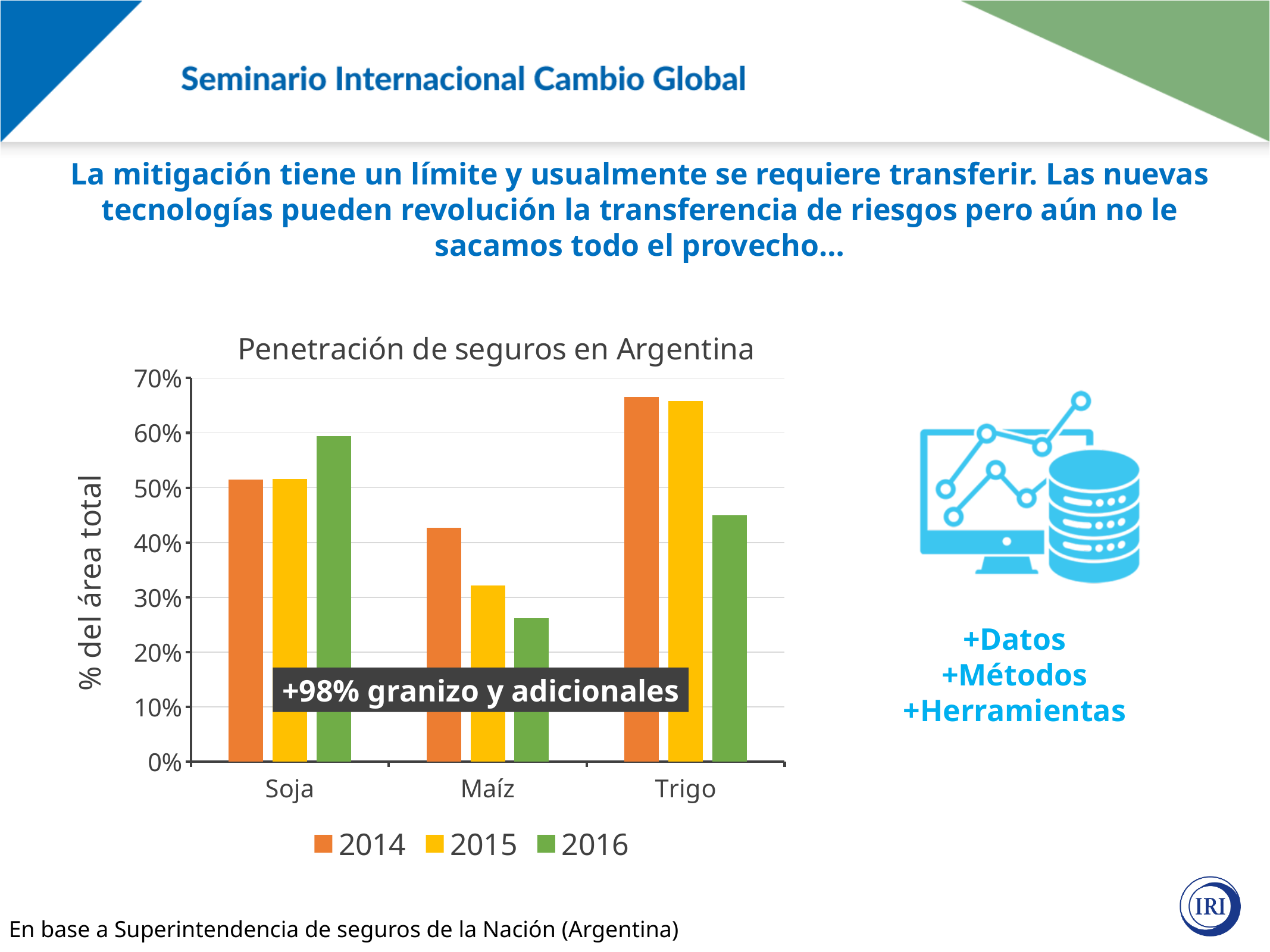
Which crop has the lowest value for 2016? Maíz Is the value for Soja in 2016 greater or less than 50%? greater How many crop categories are shown on the x axis? 3 For Trigo, which year has the larger value, 2015 or 2016? 2015 Which crop has the highest value for 2014? Trigo For Maíz, which year has the larger value, 2014 or 2015? 2014 How many series does the legend list? 3 Do the values for Maíz rise or fall from 2014 to 2016? fall What is the title of the chart? Penetración de seguros en Argentina Is the value for Maíz in 2016 greater or less than 30%? less What type of chart is shown on the slide? bar chart Is the value for Trigo in 2015 greater or less than 60%? greater